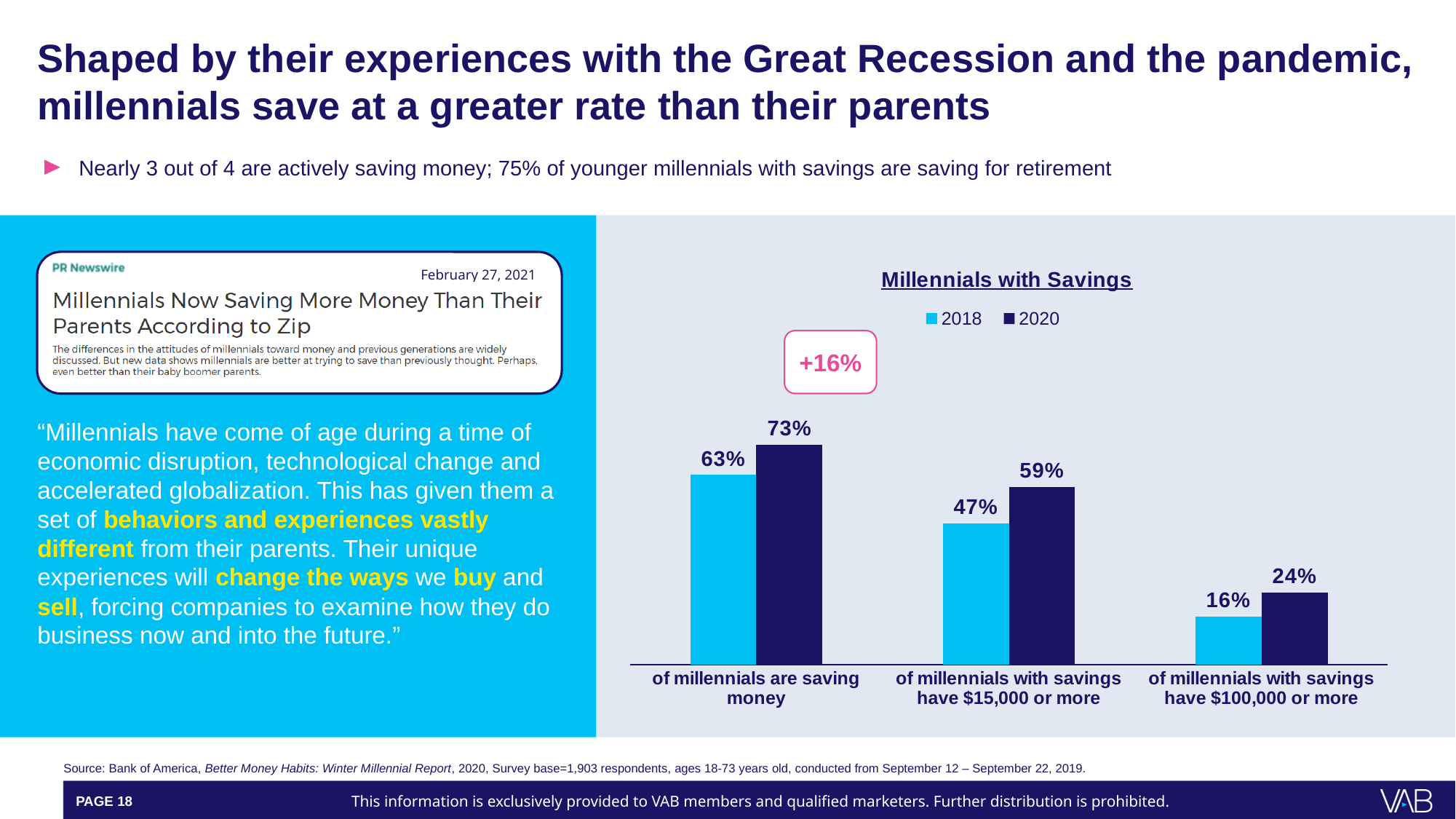
Which category has the lowest 2020 value? of millennials with savings have $100,000 or more Which category has the highest 2018 value? of millennials are saving money Which is larger: the 2018 value for 'of millennials are saving money' or the 2020 value for 'of millennials with savings have $15,000 or more'? 2018 value for 'of millennials are saving money' What kind of chart is shown on the slide? Bar chart What is the 2018 value for 'of millennials with savings have $15,000 or more'? 47% What is the difference between the 2020 and 2018 values for 'of millennials with savings have $100,000 or more'? 8% What is the title of the chart? Millennials with Savings How many categories are shown on the x axis? 3 What is the 2020 value for 'of millennials with savings have $100,000 or more'? 24% How many series does the legend list? 2 What is the 2020 value for 'of millennials are saving money'? 73% What is the difference between the 2020 and 2018 values for 'of millennials with savings have $15,000 or more'? 12%